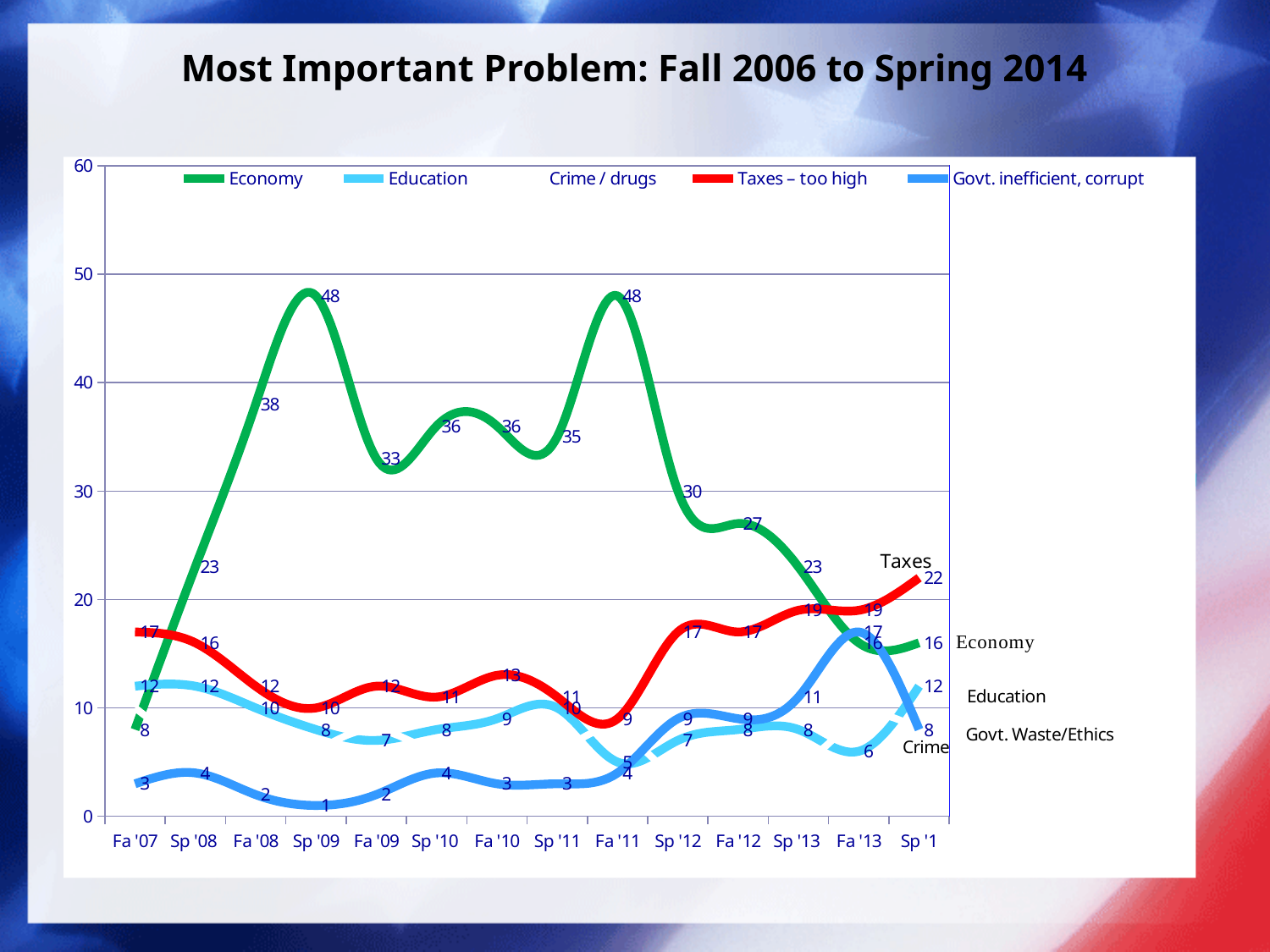
Does the Economy series rise or fall from Fa '11 to Sp '14? fall How many series does the legend list? 5 What is the difference between the Economy value at Sp '09 and at Fa '07? 40 What is the title of the chart? Most Important Problem: Fall 2006 to Spring 2014 At which time point is the Economy series lowest? Fa '07 What is the value for Taxes – too high at Sp '14 (the last point)? 22 At the last point (Sp '14), which is larger: Economy or Taxes – too high? Taxes – too high What kind of chart is shown on the slide? line chart What is the value for Govt. inefficient, corrupt at Fa '13? 17 How many time points are shown along the x axis? 14 What is the highest value reached by the Economy series? 48 What is the value for Economy at Sp '09? 48